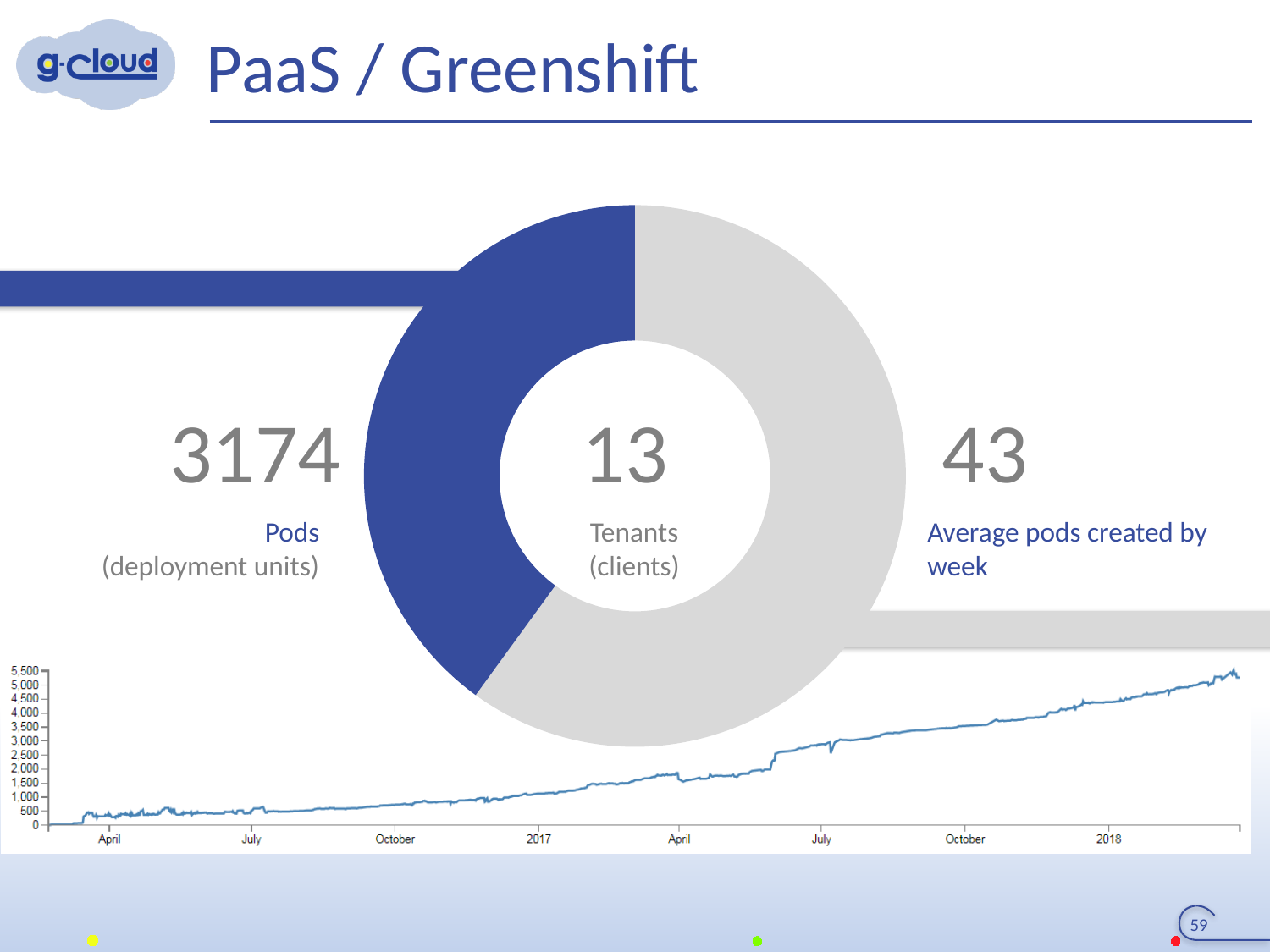
In the line chart at the bottom, do the values rise or fall from April 2016 to 2018? rise How many segments does the donut chart in the centre of the slide have? 2 In the line chart at the bottom, is the value at July 2017 greater or less than 2,000? greater In the line chart at the bottom, is the value at April 2017 greater or less than 1,000? greater In the line chart at the bottom, is the value at the end of the line greater or less than 4,500? greater In the line chart at the bottom, what is the highest value shown on the y axis? 5,500 What kind of chart is shown at the bottom of the slide? line chart In the line chart at the bottom, which is larger: the value at July 2017 or the value at July 2016? July 2017 What kind of chart is shown in the centre of the slide? donut chart